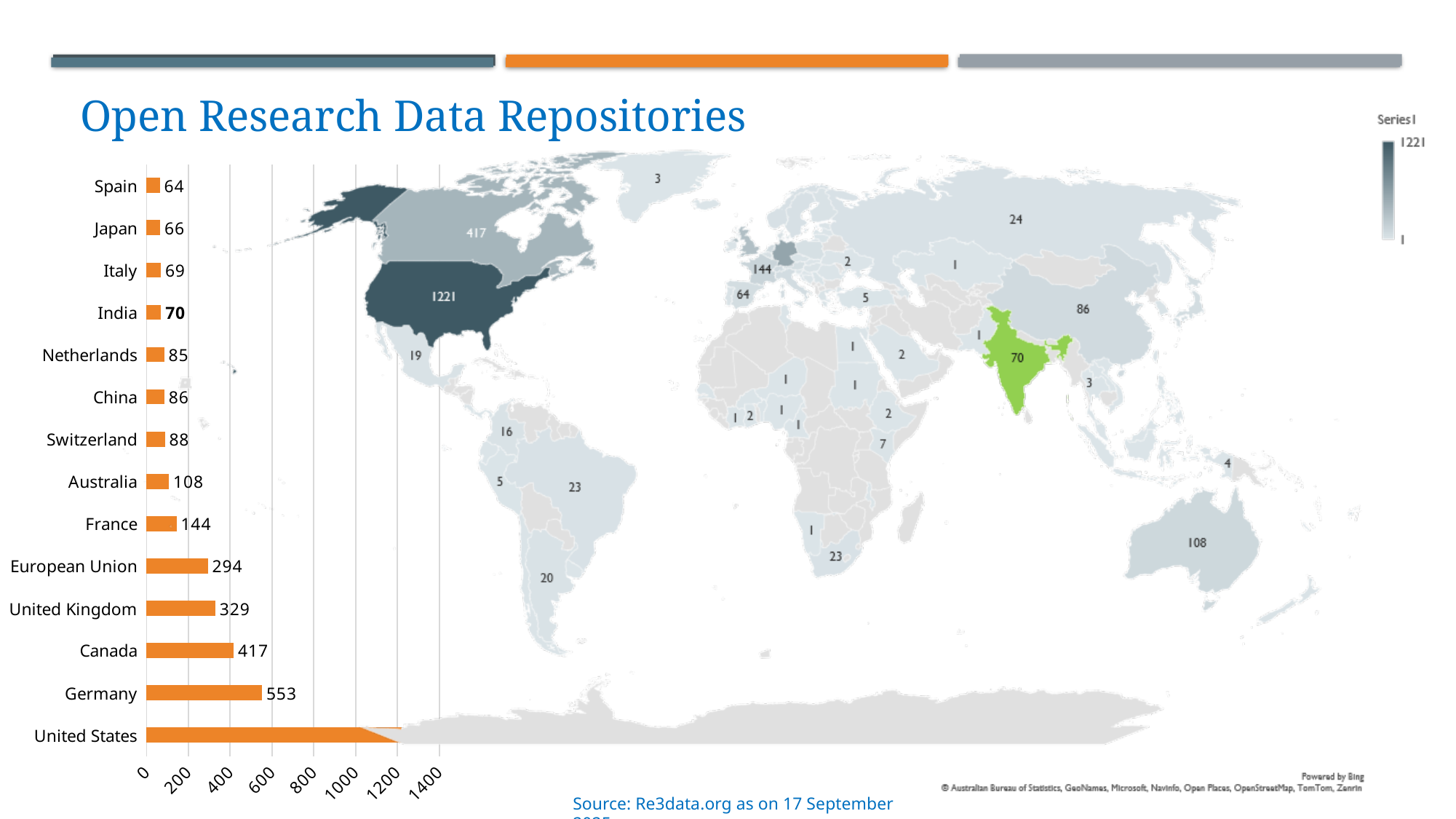
What is the title of the slide? Open Research Data Repositories In the bar chart, is the value for the United States greater or less than 1200? greater In the bar chart, which is larger, the value for the United Kingdom or the European Union? United Kingdom In the bar chart, which category has the lowest value? Spain In the bar chart, what is the value for Australia? 108 In the bar chart, what is the difference between the values for Germany and Canada? 136 In the bar chart, which country has the longest bar? United States On the map chart, what value is shown for India? 70 In the bar chart, what is the value for Germany? 553 In the bar chart, what is the value for Canada? 417 What kind of chart is shown on the left of the slide? bar chart How many categories are shown in the bar chart? 14